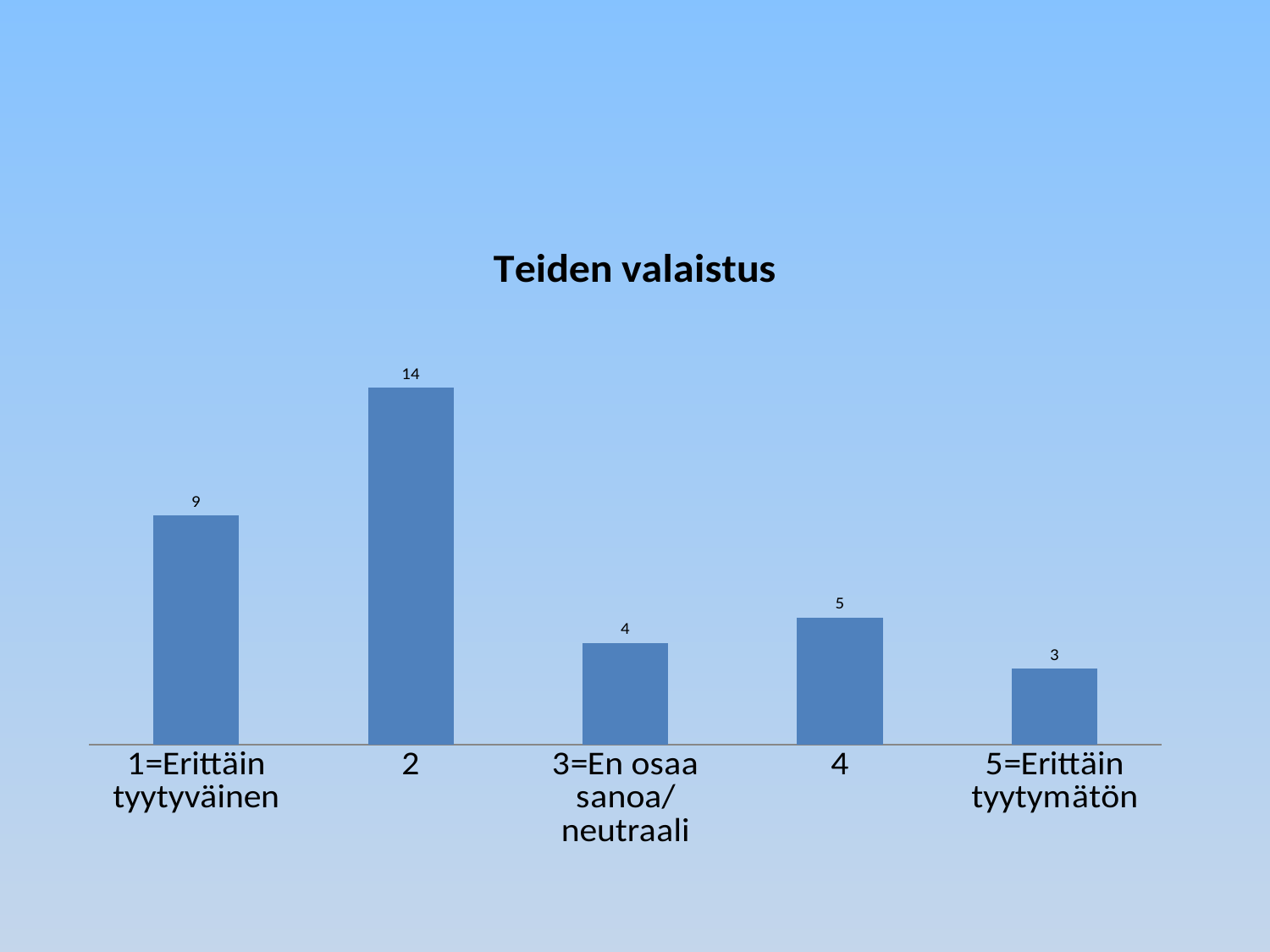
What is the difference between the values for "4" and "5=Erittäin tyytymätön"? 2 Which category has the lowest value? 5=Erittäin tyytymätön Which category has the highest value? 2 What is the value for "1=Erittäin tyytyväinen"? 9 What is the value for the category "2"? 14 What is the value for "3=En osaa sanoa/neutraali"? 4 What is the difference between the values for "2" and "1=Erittäin tyytyväinen"? 5 Which is larger, the value for "4" or the value for "3=En osaa sanoa/neutraali"? 4 What is the title of the chart? Teiden valaistus What is the value for "5=Erittäin tyytymätön"? 3 How many categories are shown on the x axis? 5 What kind of chart is shown on the slide? Bar chart